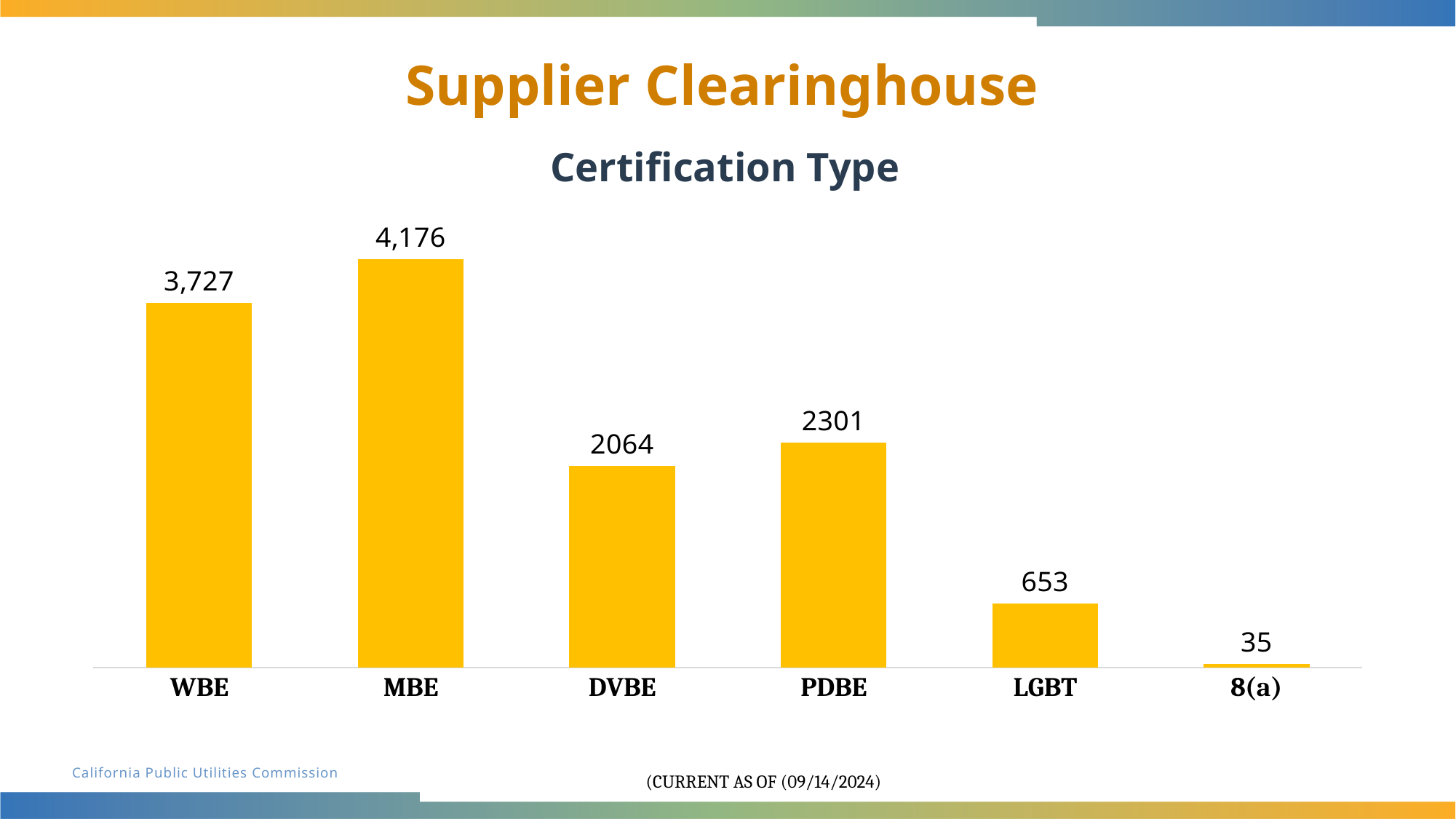
Which is larger, the value for PDBE or the value for DVBE? PDBE How many certification types are shown in the chart? 6 Which certification type has the lowest value? 8(a) What is the title of the chart? Certification Type What is the difference between the values for PDBE and DVBE? 237 What kind of chart is shown on the slide? Bar chart Which certification type has the highest value? MBE What is the difference between the values for MBE and WBE? 449 What is the value for 8(a)? 35 What is the value for DVBE? 2064 What is the value for MBE? 4,176 What is the value for LGBT? 653